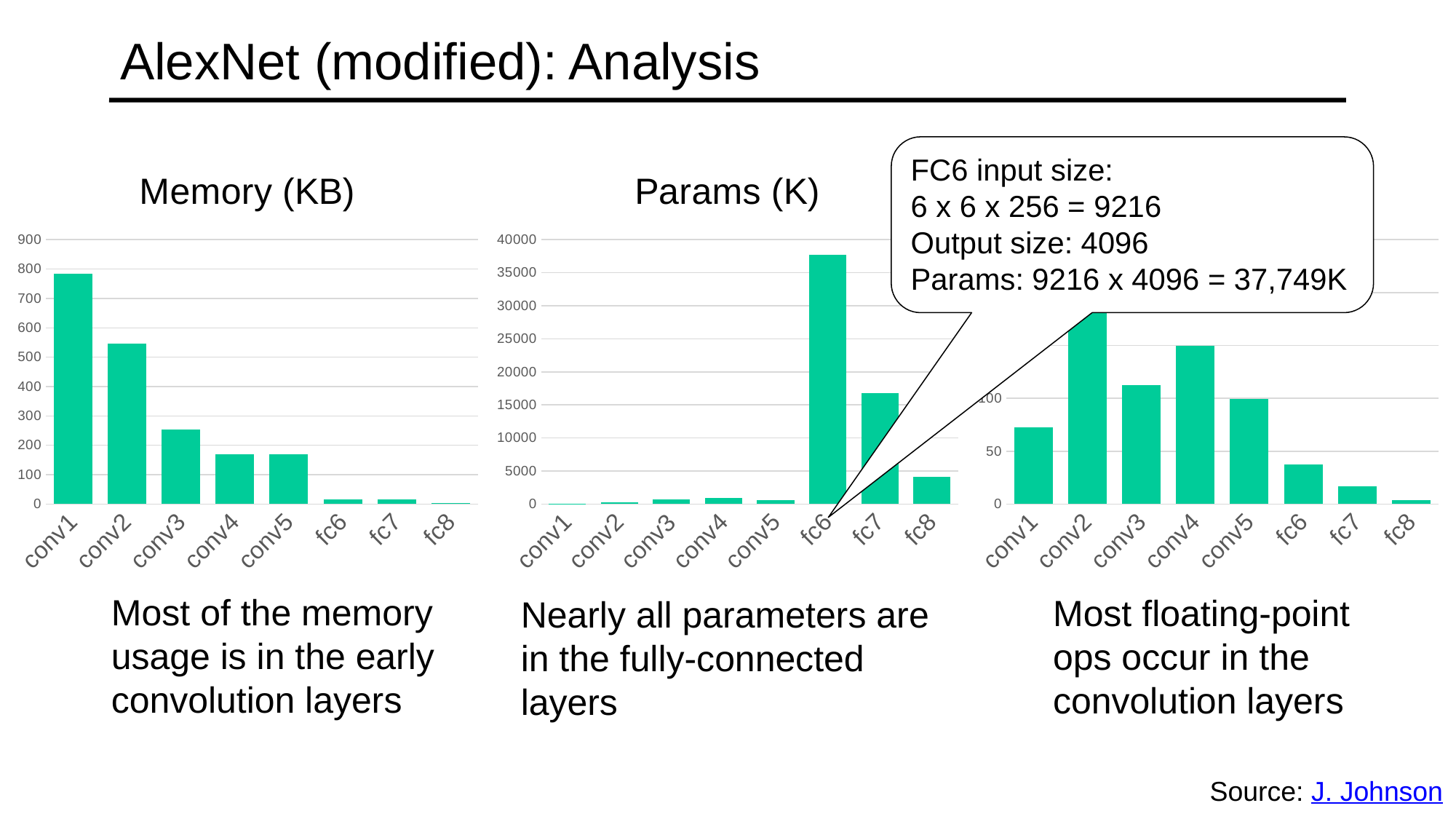
In the Memory (KB) chart, which layer has the highest memory usage? conv1 How many layers are shown on the x axis of the Memory (KB) chart? 8 What kind of chart is the Memory (KB) chart? bar chart In the rightmost chart, is the value for fc6 greater or less than 50? less In the Memory (KB) chart, which is larger, the value for conv2 or the value for conv3? conv2 In the Params (K) chart, which layer has the highest number of parameters? fc6 In the Memory (KB) chart, is the value for conv1 greater or less than 700? greater In the Params (K) chart, is the value for fc8 greater or less than 5000? less In the rightmost chart, which layer has the highest value? conv2 In the Params (K) chart, which is larger, the value for fc7 or the value for fc8? fc7